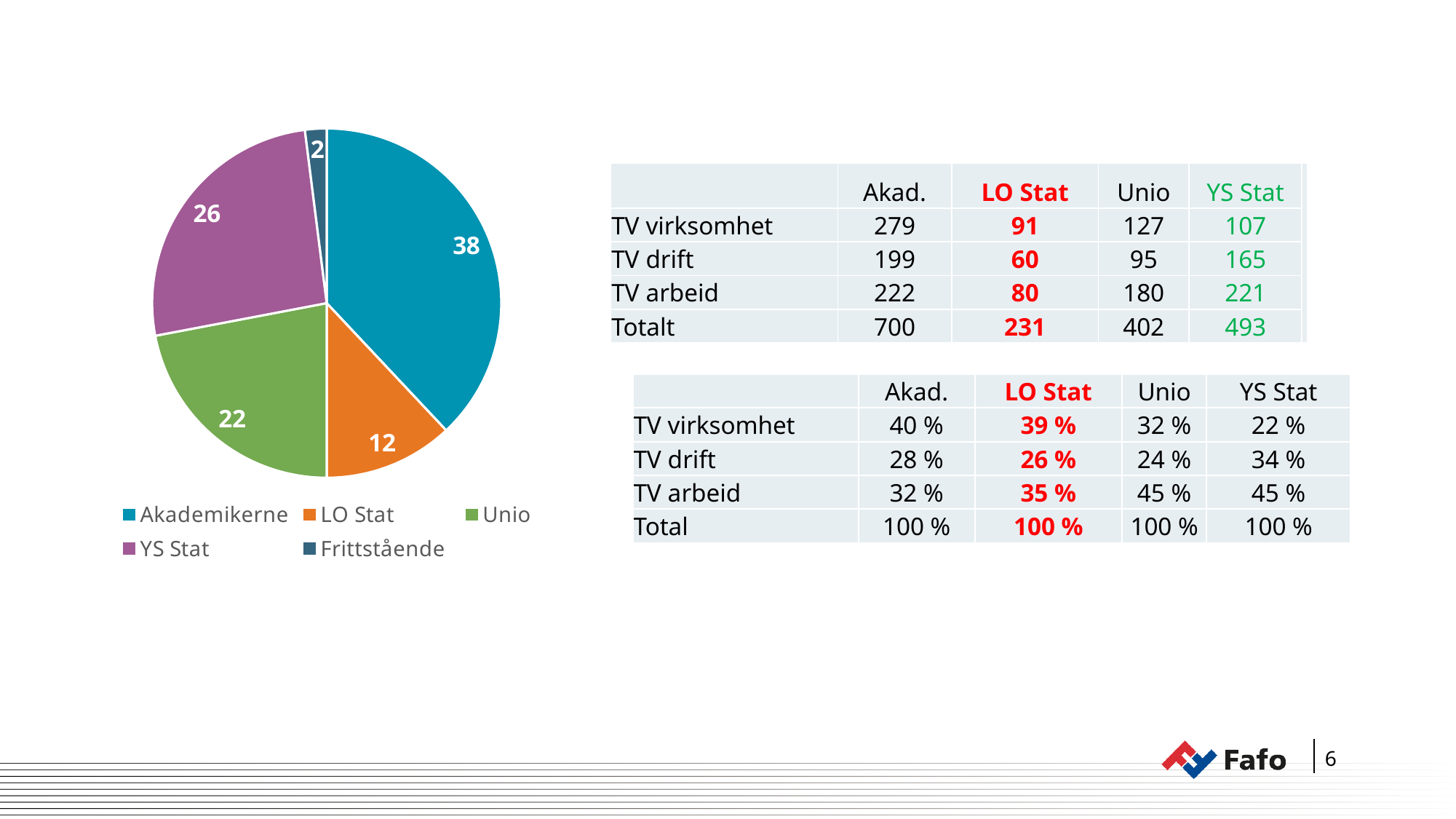
In the pie chart, which is larger: the value for Unio or the value for YS Stat? YS Stat Which legend entry in the pie chart is shown in orange? LO Stat In the pie chart, what is the value for YS Stat? 26 How many slices does the pie chart have? 5 In the pie chart, what is the value for LO Stat? 12 What kind of chart is shown on the slide? pie chart Which slice of the pie chart is the smallest? Frittstående In the pie chart, what is the value for Akademikerne? 38 In the pie chart, what is the value for Frittstående? 2 In the pie chart, what is the difference between the values for Akademikerne and YS Stat? 12 In the pie chart, what is the value for Unio? 22 Which slice of the pie chart is the largest? Akademikerne